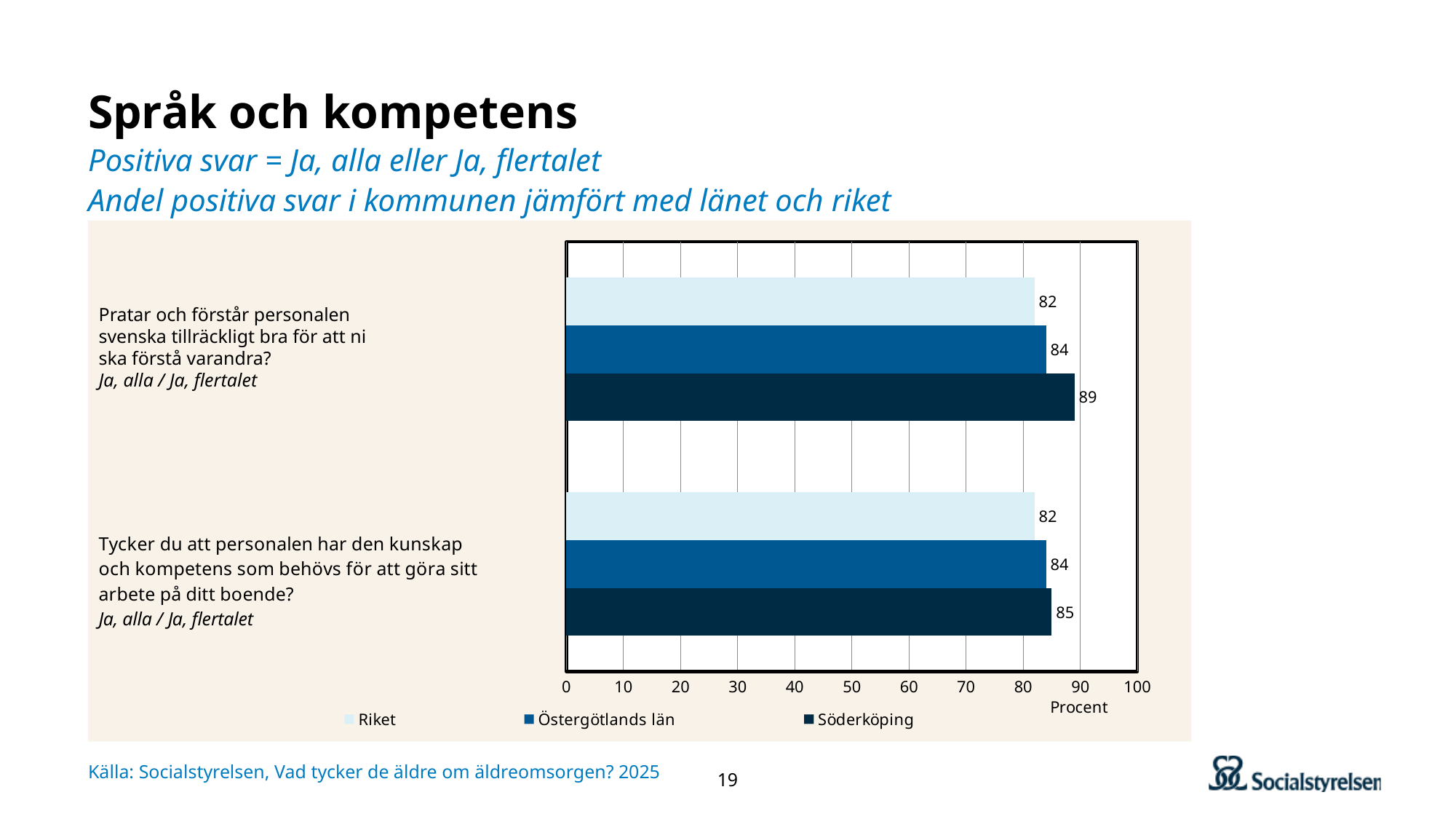
What is the value for Östergötlands län on the question "Pratar och förstår personalen svenska tillräckligt bra för att ni ska förstå varandra?"? 84 What is the difference between Söderköping and Riket on the question "Pratar och förstår personalen svenska tillräckligt bra för att ni ska förstå varandra?"? 7 What unit is shown on the horizontal axis of the chart? Procent What kind of chart is shown on the slide? Bar chart Is the value for Söderköping on the question "Pratar och förstår personalen svenska tillräckligt bra för att ni ska förstå varandra?" greater or less than 80? greater Which series has the highest value on the question "Pratar och förstår personalen svenska tillräckligt bra för att ni ska förstå varandra?"? Söderköping What is the value for Riket on the question "Tycker du att personalen har den kunskap och kompetens som behövs för att göra sitt arbete på ditt boende?"? 82 What is the value for Söderköping on the question "Tycker du att personalen har den kunskap och kompetens som behövs för att göra sitt arbete på ditt boende?"? 85 What is the value for Söderköping on the question "Pratar och förstår personalen svenska tillräckligt bra för att ni ska förstå varandra?"? 89 Which series has the lowest value on the question "Tycker du att personalen har den kunskap och kompetens som behövs för att göra sitt arbete på ditt boende?"? Riket What is the difference between Söderköping and Östergötlands län on the question "Tycker du att personalen har den kunskap och kompetens som behövs för att göra sitt arbete på ditt boende?"? 1 How many series does the legend list? 3